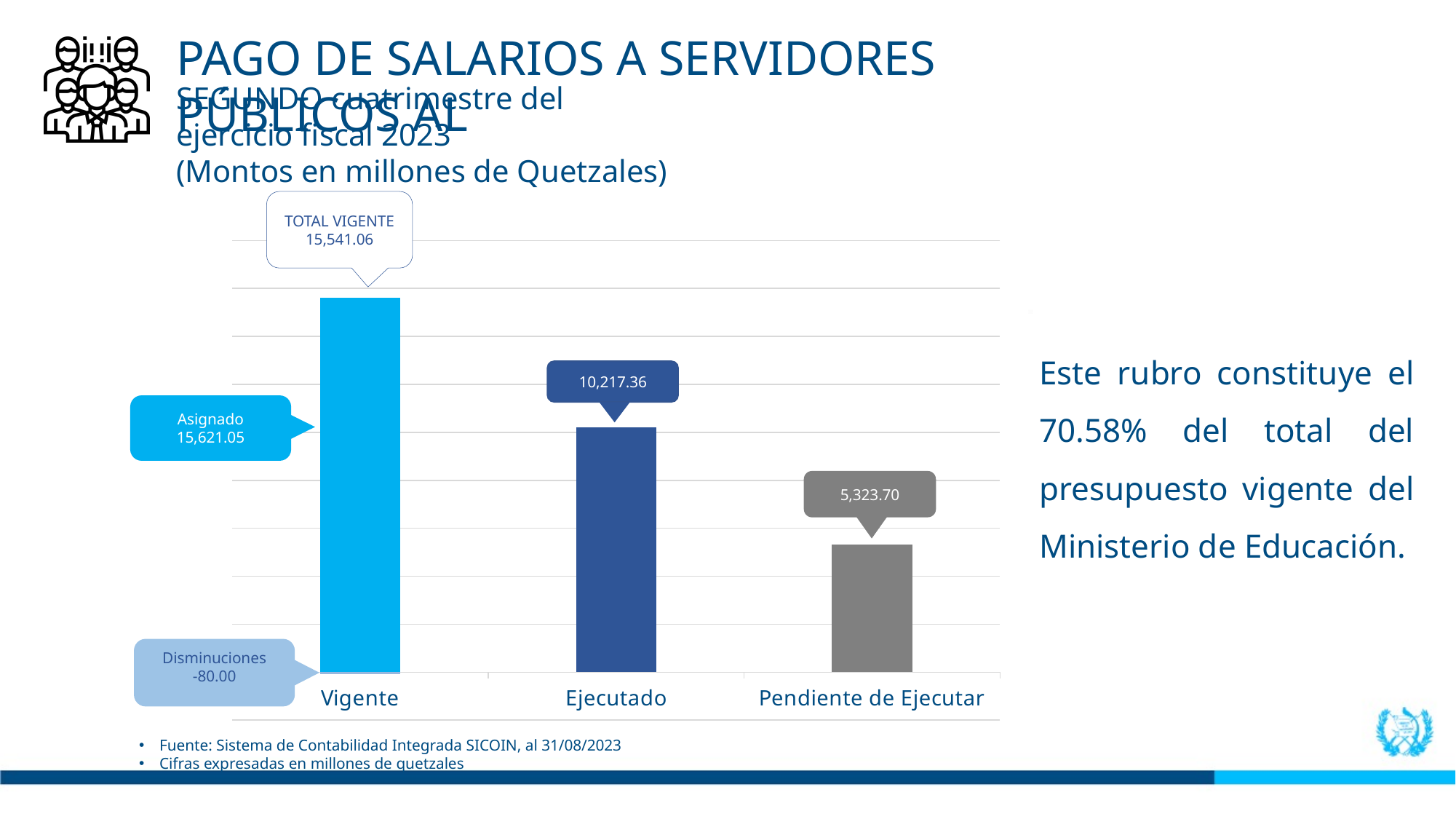
What is the value shown for Pendiente de Ejecutar? 5,323.70 Which category has the lowest bar? Pendiente de Ejecutar What is the Disminuciones value shown in the callout next to the Vigente bar? -80.00 What is the TOTAL VIGENTE value shown above the Vigente bar? 15,541.06 Which category has the highest bar? Vigente How many categories are plotted on the x axis of the chart? 3 What is the value shown for Ejecutado? 10,217.36 What type of chart is shown on the slide? bar chart What is the Asignado value shown in the callout next to the Vigente bar? 15,621.05 What is the difference between the Ejecutado value and the Pendiente de Ejecutar value? 4,893.66 Do the bar values rise or fall from left to right across the x axis? fall Which is larger, the value for Ejecutado or the value for Pendiente de Ejecutar? Ejecutado